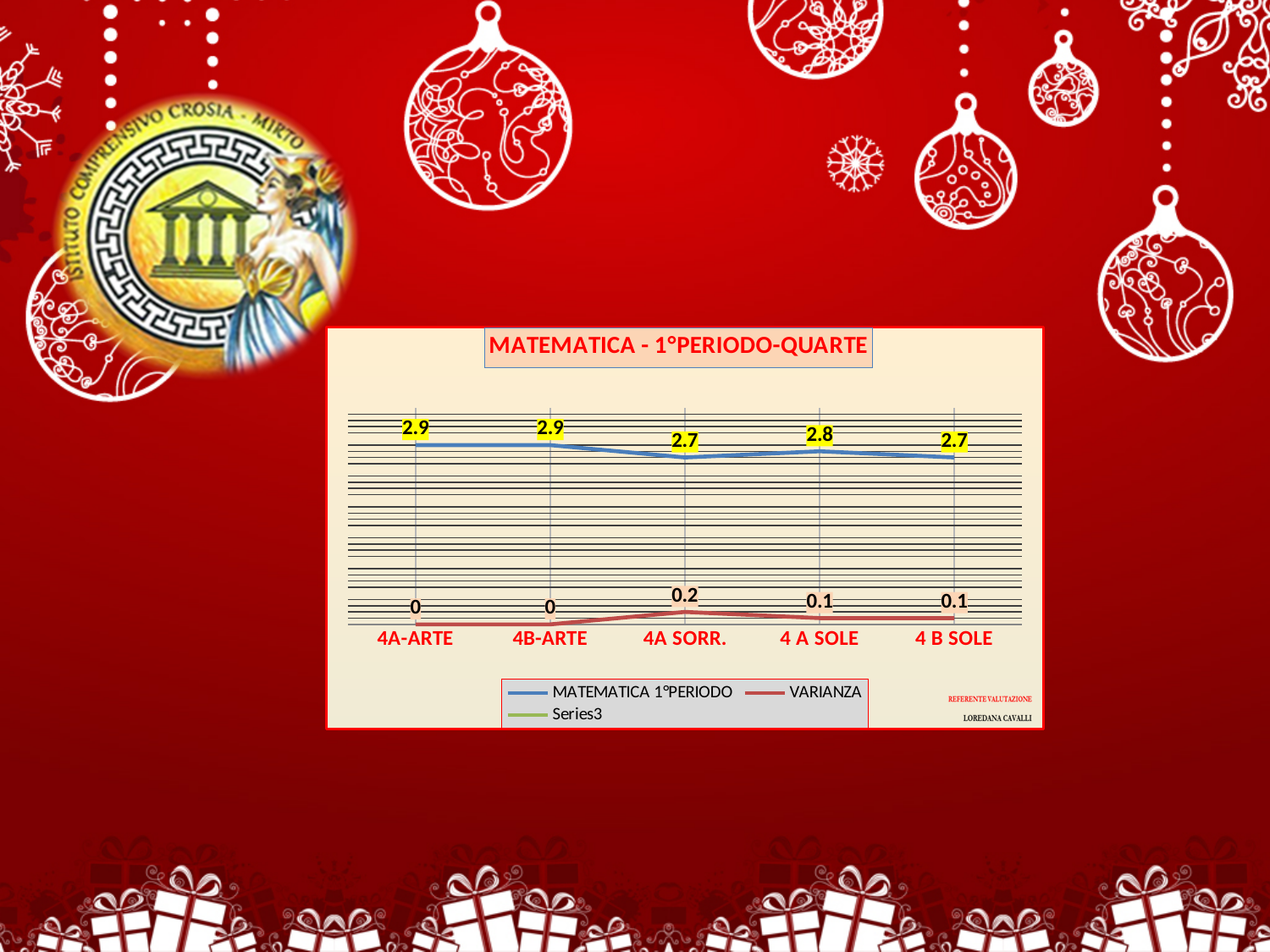
Which is larger, the MATEMATICA 1°PERIODO value for 4 A SOLE or for 4 B SOLE? 4 A SOLE Which category has the highest VARIANZA value? 4A SORR. How many categories are shown on the x axis? 5 What is the difference between the MATEMATICA 1°PERIODO values for 4A-ARTE and 4A SORR.? 0.2 How many series does the legend list? 3 What colour is the line for the VARIANZA series? red What kind of chart is shown on the slide? line chart What is the title of the chart? MATEMATICA - 1°PERIODO-QUARTE What is the MATEMATICA 1°PERIODO value for 4A SORR.? 2.7 What is the VARIANZA value for 4B-ARTE? 0 What is the VARIANZA value for 4A SORR.? 0.2 What is the MATEMATICA 1°PERIODO value for 4 A SOLE? 2.8